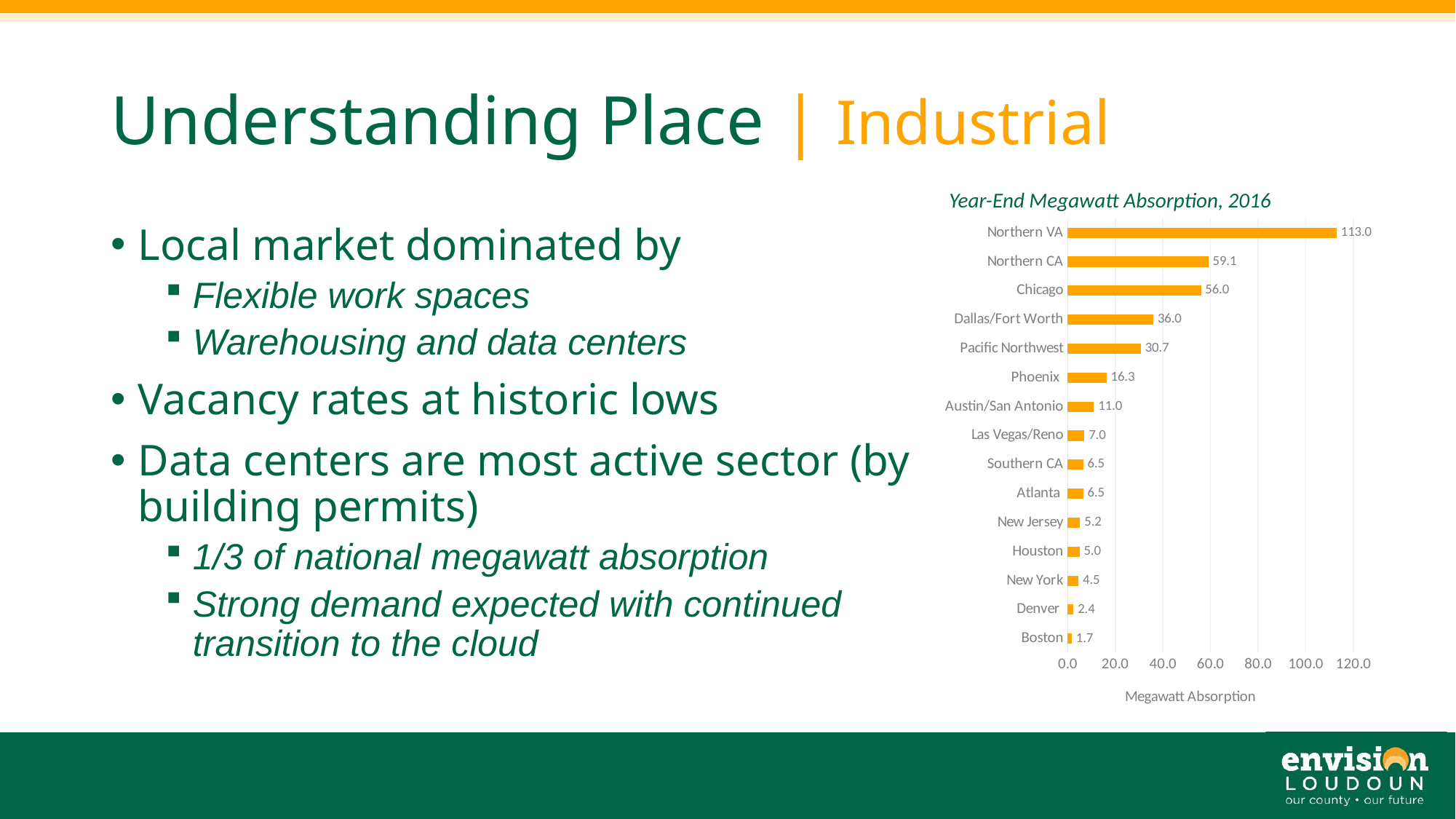
Which market has the highest megawatt absorption? Northern VA Is the value for Northern CA greater or less than 40.0? greater What is the title of the chart? Year-End Megawatt Absorption, 2016 Which market has the lowest megawatt absorption? Boston Which has a larger megawatt absorption, Las Vegas/Reno or Houston? Las Vegas/Reno What is the difference in megawatt absorption between Northern VA and Northern CA? 53.9 How many markets are shown in the chart? 15 What kind of chart is shown on the slide? Bar chart What is the difference in megawatt absorption between Dallas/Fort Worth and Phoenix? 19.7 What is the megawatt absorption value for Pacific Northwest? 30.7 What is the megawatt absorption value for Northern VA? 113.0 What is the megawatt absorption value for Chicago? 56.0